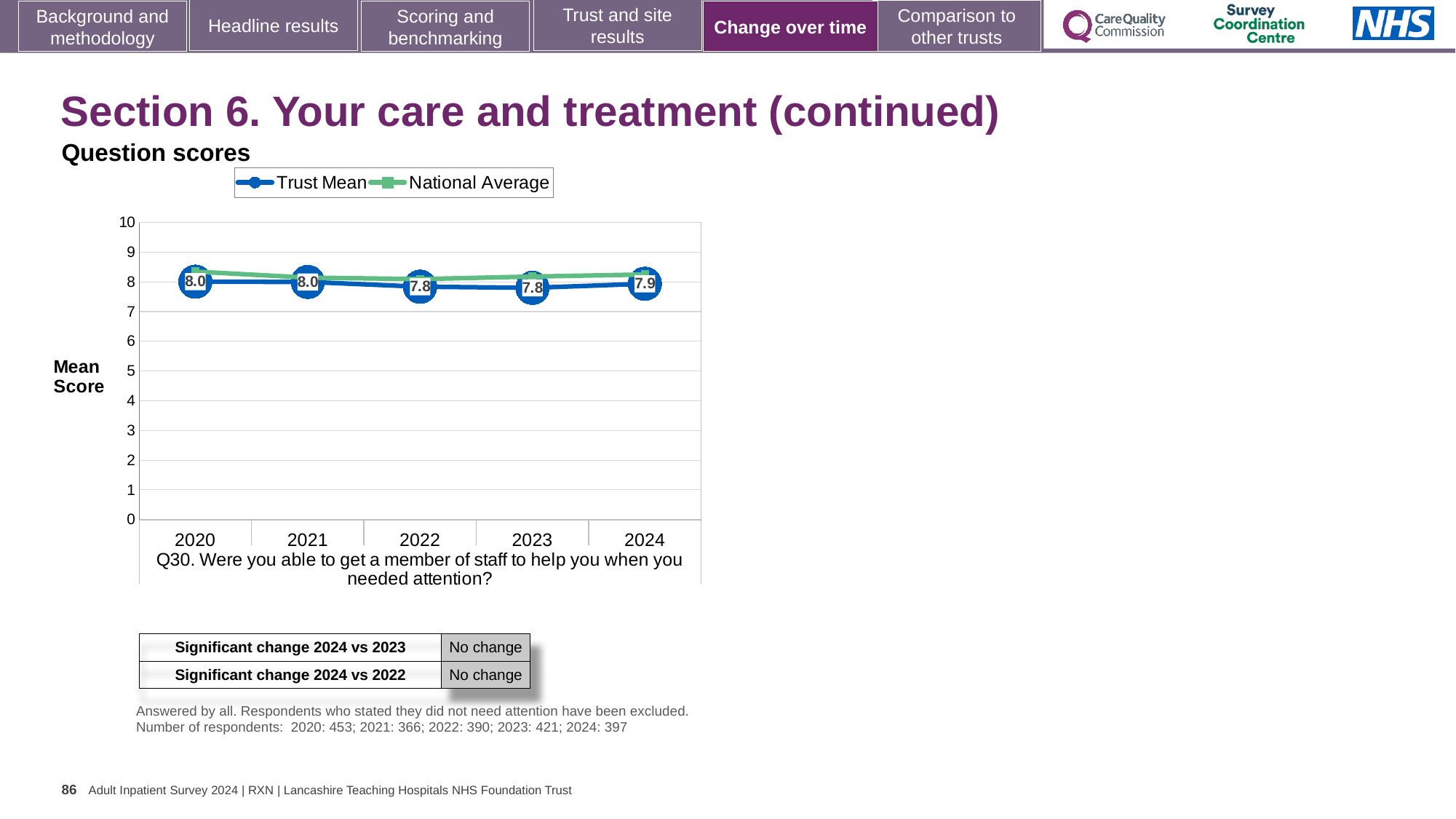
Is the National Average value for 2020 greater or less than 7? greater What is the Trust Mean value for 2024? 7.9 What is the Trust Mean value for 2020? 8.0 Which is larger, the Trust Mean for 2022 or the Trust Mean for 2024? 2024 How many series does the legend list? 2 What is the difference between the Trust Mean in 2020 and the Trust Mean in 2022? 0.2 What is the Trust Mean value for 2023? 7.8 Does the Trust Mean rise or fall from 2021 to 2022? Fall How many years are plotted on the x axis? 5 What is the Trust Mean value for 2022? 7.8 What kind of chart is shown on the slide? Line chart What are the two series named in the legend? Trust Mean and National Average